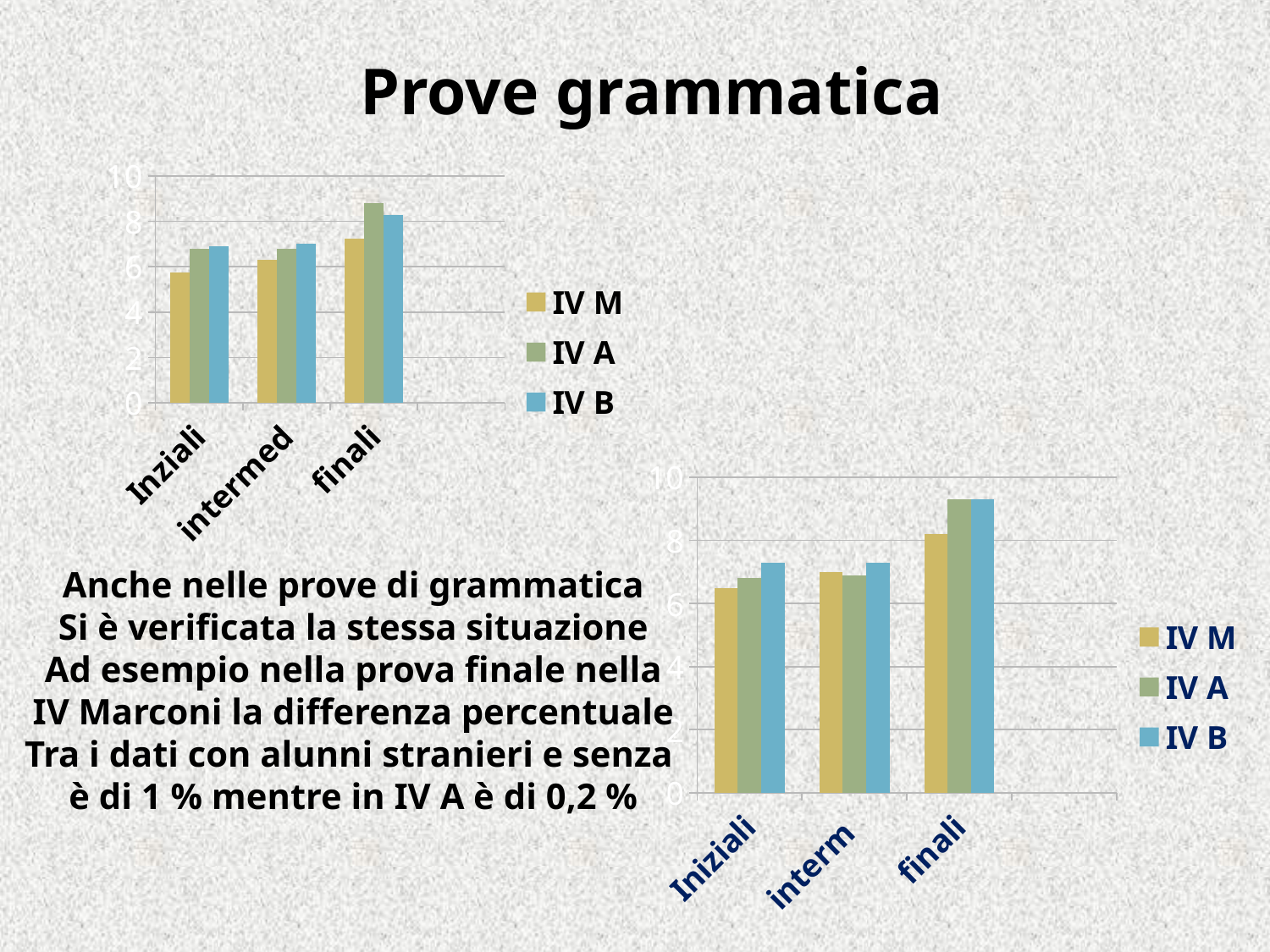
In the top-left chart, is the value for IV A in the finali category greater or less than 8? greater In the bottom-right chart, which series has the lowest value in the finali category? IV M In the top-left chart, do the values for IV M rise or fall from Inziali to finali? rise In the top-left chart, is the value for IV M in the Inziali category greater or less than 6? less How many categories are shown on the x axis of the top-left chart? 3 In the top-left chart, which category has the lowest value for IV M? Inziali What is the title of the slide containing the two charts? Prove grammatica What kind of chart is the top-left chart? bar chart How many series does the legend of the bottom-right chart list? 3 In the bottom-right chart, is the value for IV B in the Iniziali category greater or less than 8? less In the top-left chart, which category has the highest value for IV M? finali